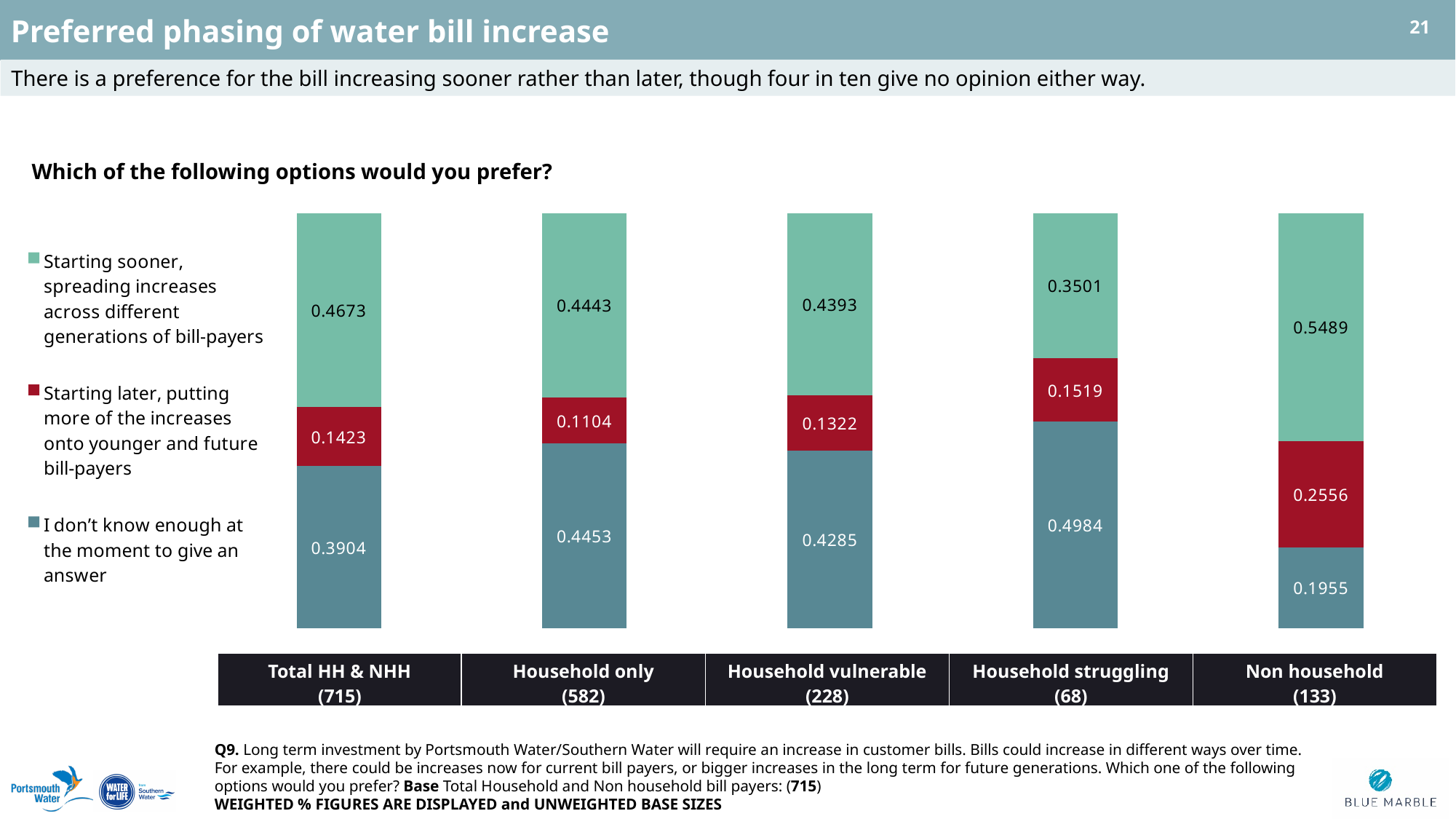
How many groups are shown along the x axis of the chart? 5 In the Household struggling group, which is larger: 'Starting sooner' or 'I don't know enough at the moment to give an answer'? I don't know enough at the moment to give an answer How many series does the chart legend list? 3 Which group has the highest value for 'Starting sooner, spreading increases across different generations of bill-payers'? Non household What is the value for 'Starting later, putting more of the increases onto younger and future bill-payers' in the Non household group? 0.2556 What is the value for 'Starting later, putting more of the increases onto younger and future bill-payers' in the Household vulnerable group? 0.1322 What is the value for 'I don't know enough at the moment to give an answer' in the Household struggling group? 0.4984 Which group has the lowest value for 'Starting later, putting more of the increases onto younger and future bill-payers'? Household only In the Non household group, what is the difference between the 'Starting sooner' value and the 'Starting later' value? 0.2933 Which group has the lowest value for 'I don't know enough at the moment to give an answer'? Non household What kind of chart is shown on the slide? Stacked bar chart What is the value for 'Starting sooner, spreading increases across different generations of bill-payers' in the Total HH & NHH group? 0.4673